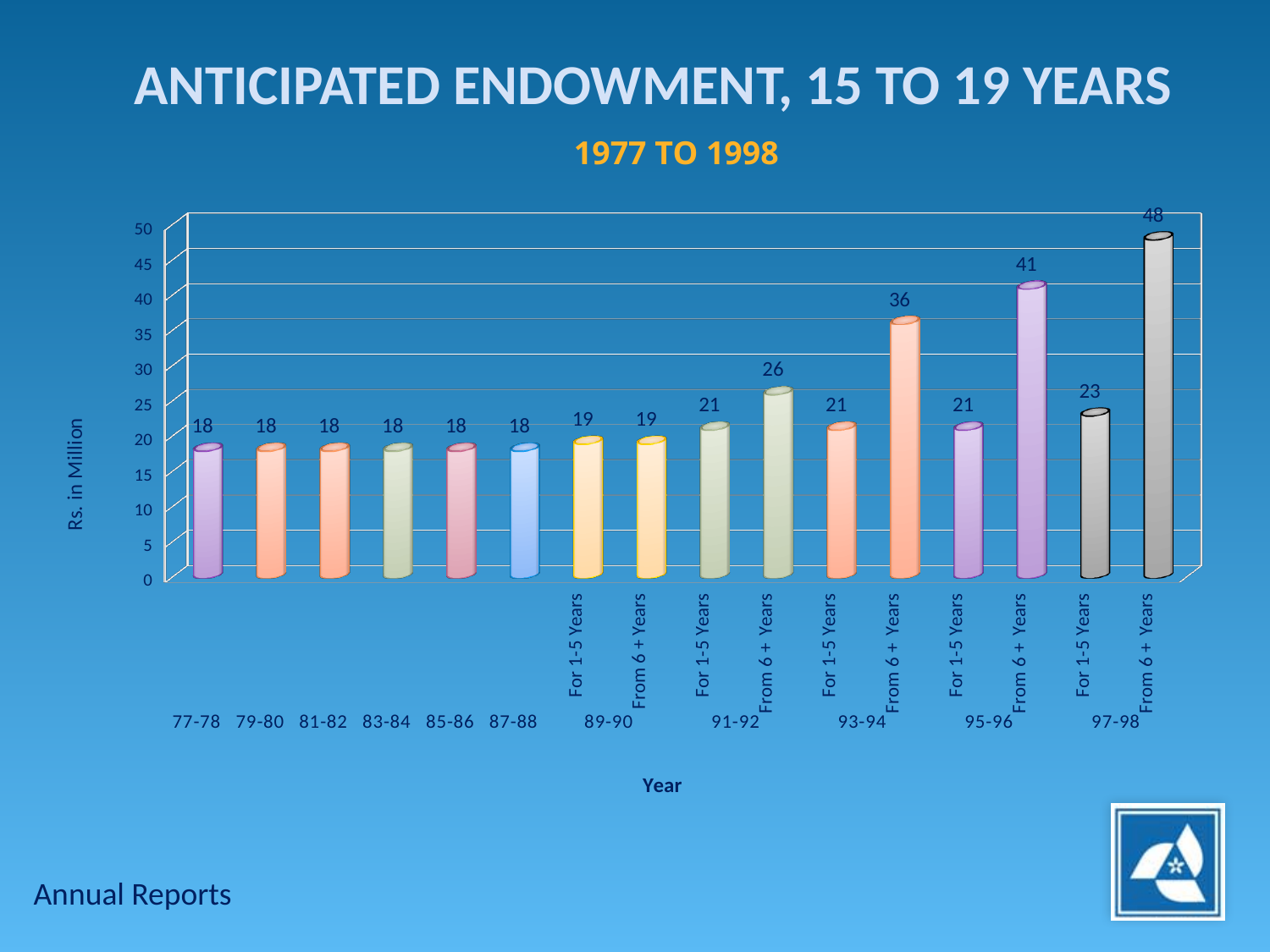
What is the value for 91-92 For 1-5 Years? 21 What is the value for 77-78? 18 What kind of chart is shown on the slide? Bar chart How many bars are plotted in the chart? 16 Which bar has the highest value? 97-98 From 6 + Years Do the values for the From 6 + Years bars rise or fall from 89-90 to 97-98? Rise What is the value for 97-98 From 6 + Years? 48 Which is larger, the value for 91-92 From 6 + Years or the value for 93-94 For 1-5 Years? 91-92 From 6 + Years What is the label of the vertical axis? Rs. in Million What is the difference between 95-96 From 6 + Years and 93-94 From 6 + Years? 5 What is the difference between 97-98 From 6 + Years and 97-98 For 1-5 Years? 25 What is the value for 93-94 From 6 + Years? 36